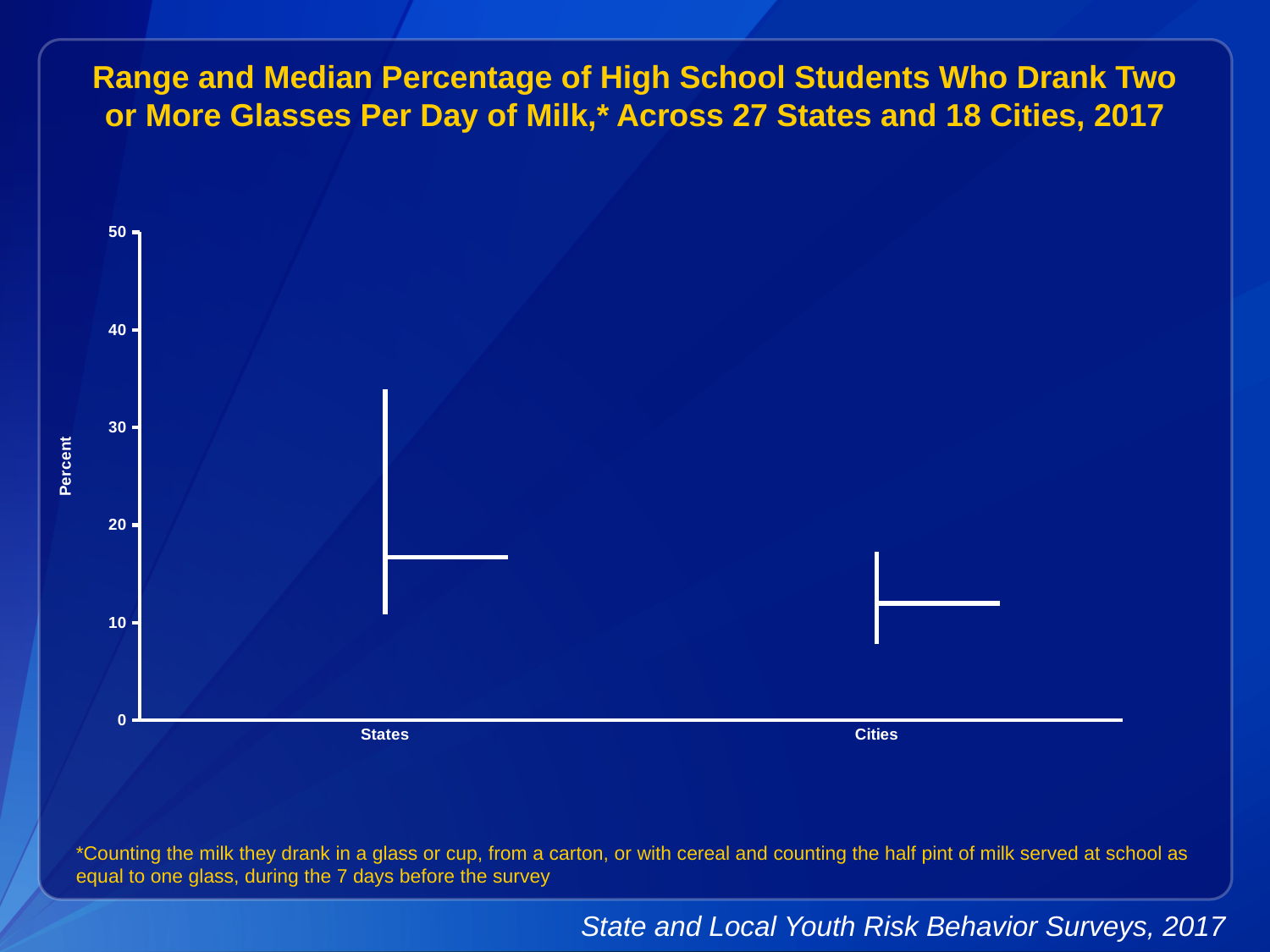
Which category has the higher median percentage, States or Cities? States Is the top of the range for Cities greater or less than 20? less Is the median value for States greater or less than 20? less Is the median value for Cities greater or less than 20? less Which category has the lower median percentage? Cities What is the highest value shown on the y axis? 50 How many categories are shown on the x axis of the chart? 2 What is the label on the y axis of the chart? Percent Which category shows the wider range of values, States or Cities? States